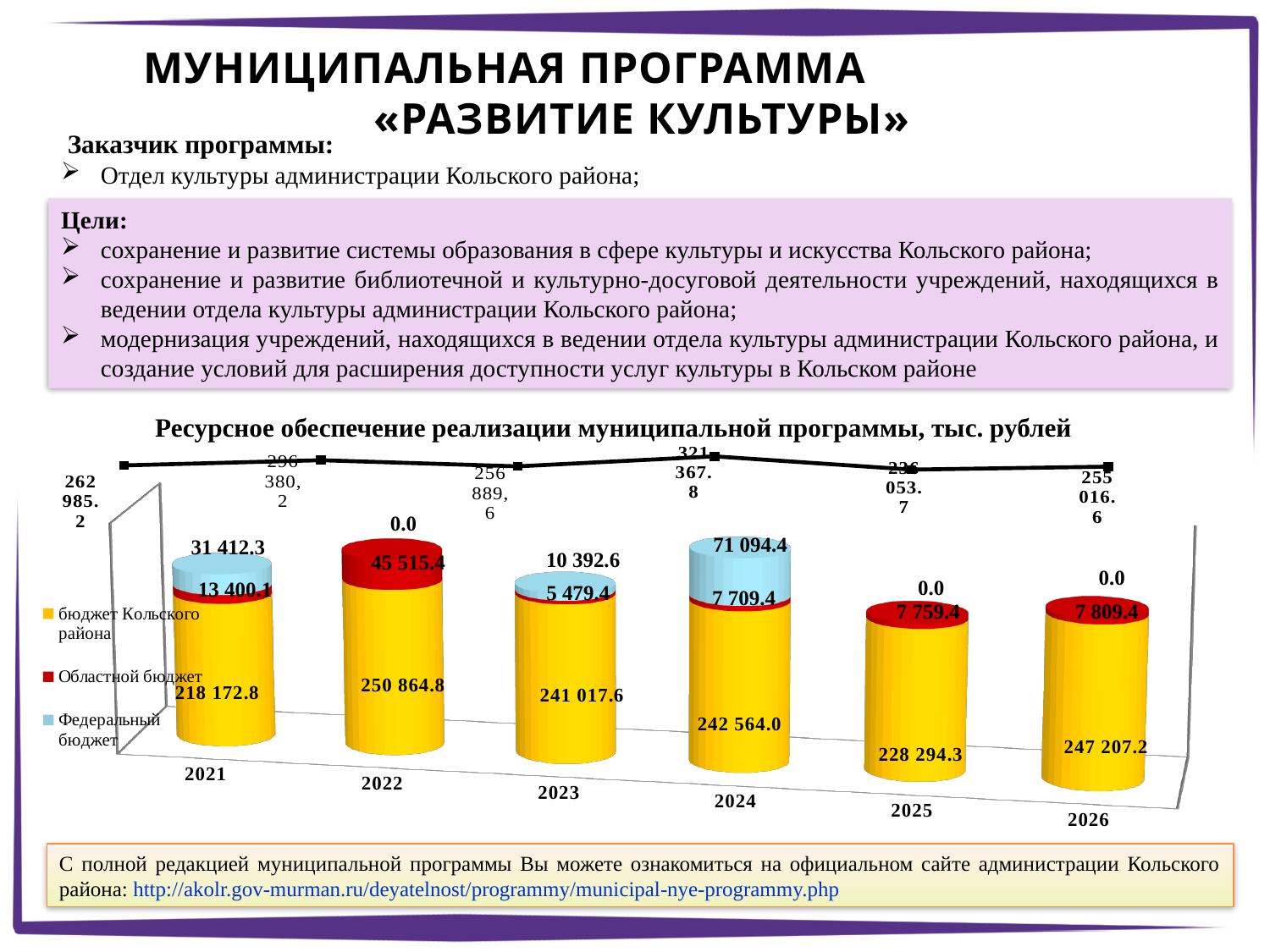
How many years are shown on the x axis of the chart? 6 What is the title of the chart? Ресурсное обеспечение реализации муниципальной программы, тыс. рублей Which year has the highest value for Федеральный бюджет? 2024 For 2023, which is larger: Федеральный бюджет or Областной бюджет? Федеральный бюджет What is the value of бюджет Кольского района for 2021? 218 172.8 What is the total resource provision shown for 2021? 262 985.2 Which year has the lowest value for бюджет Кольского района? 2021 What is the value of Областной бюджет for 2022? 45 515.4 What is the value of Федеральный бюджет for 2024? 71 094.4 How many series does the chart legend list? 3 What is the difference between the Областной бюджет values for 2026 and 2025? 50.0 What is the difference between the Федеральный бюджет values for 2024 and 2021? 39 682.1